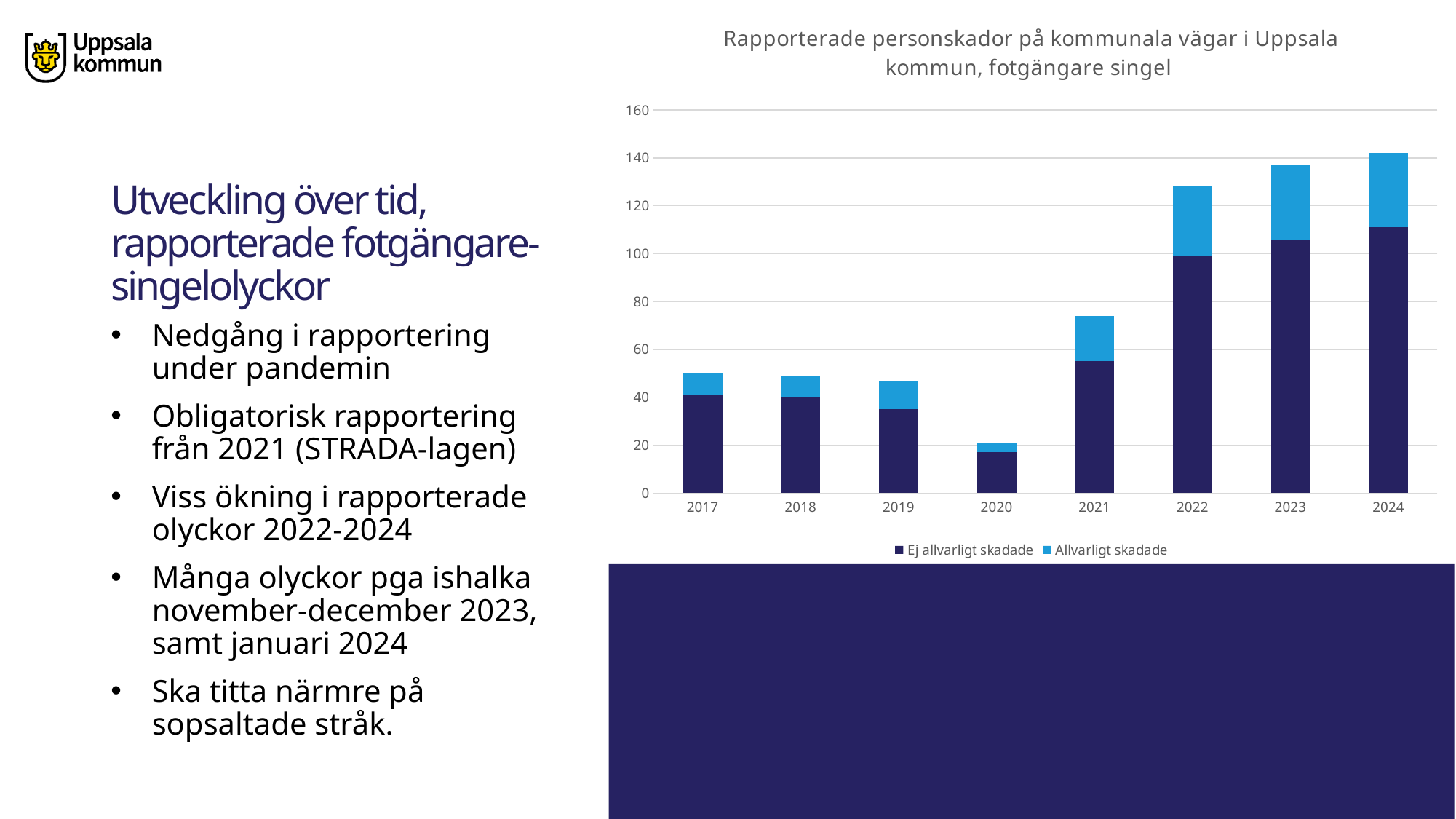
What are the two series named in the chart's legend? Ej allvarligt skadade and Allvarligt skadade Do the total values rise or fall from 2021 to 2024? rise Which year has the highest total bar in the chart? 2024 Which year has a larger total bar, 2019 or 2021? 2021 Is the total value for 2020 greater or less than 40? less How many series does the chart's legend list? 2 Is the total value for 2017 greater or less than 60? less Is the total value for 2021 greater or less than 60? greater How many years are shown on the x axis of the chart? 8 Which year has the lowest total bar in the chart? 2020 What kind of chart is shown on the slide? Bar chart (stacked)